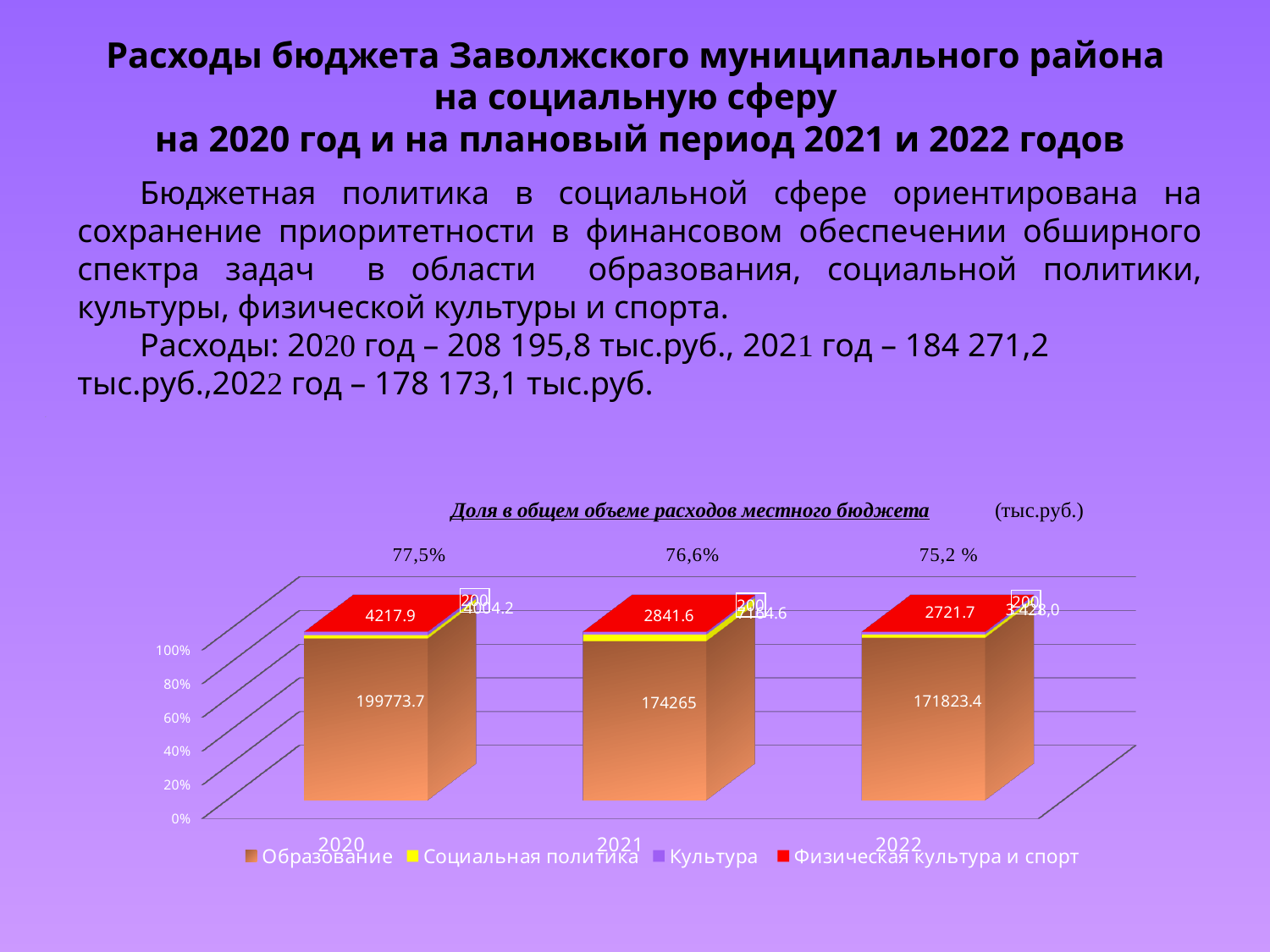
What is the value for Образование in 2020? 199773.7 Do the values for Образование rise or fall from 2020 to 2022? fall What is the value for Образование in 2022? 171823.4 How many years (categories) are shown on the x axis of the chart? 3 What is the difference between the Образование values for 2020 and 2021? 25508.7 What is the value for Физическая культура и спорт in 2020? 200 In which year is the value for Образование the highest? 2020 How many series does the chart legend list? 4 What is the value for Образование in 2021? 174265 What is the value for Физическая культура и спорт in 2022? 200 What kind of chart is shown on the slide? bar chart